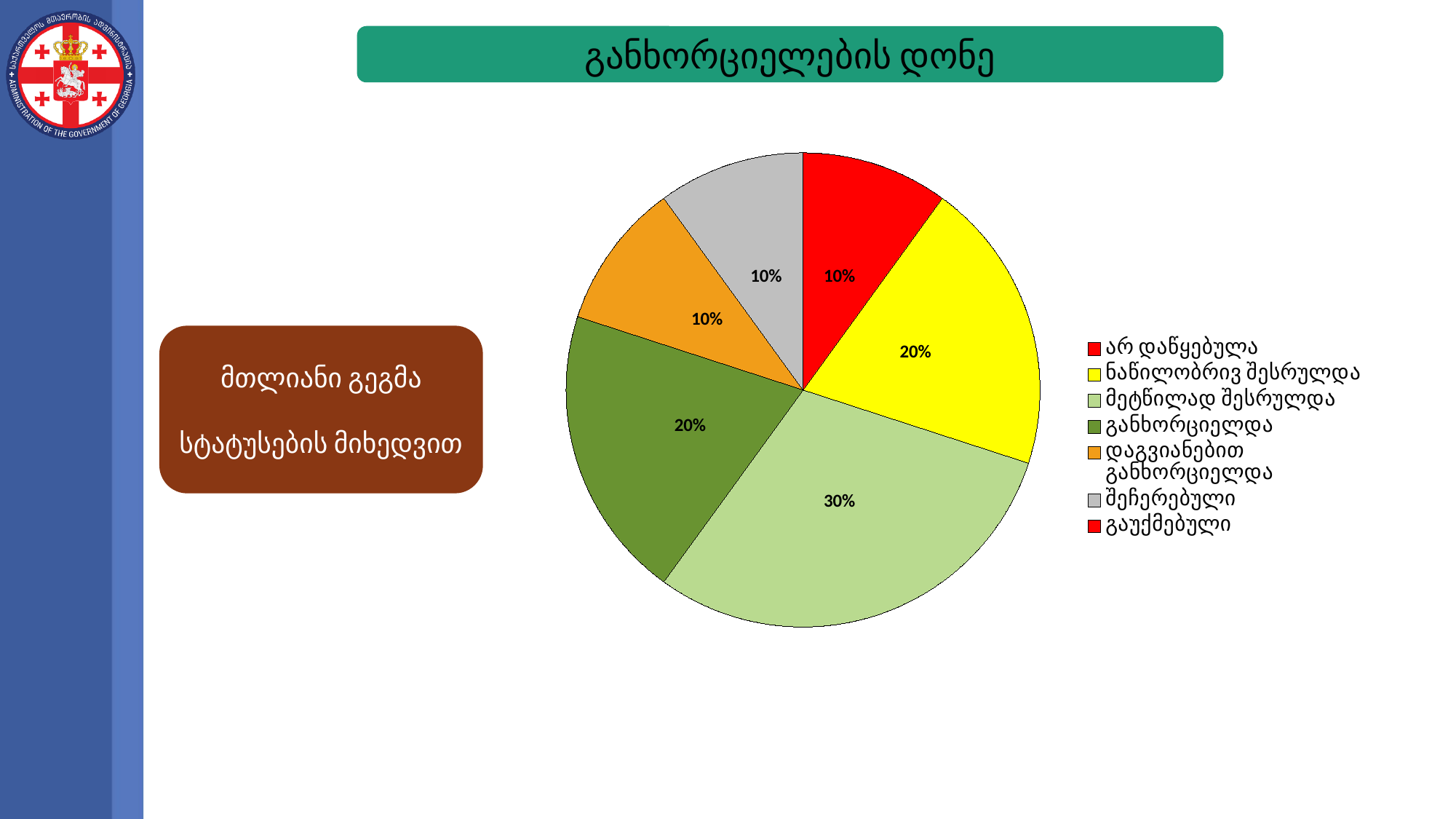
How many entries does the legend list? 7 What is the difference between the share for მეტწილად შესრულდა and the share for განხორციელდა? 10% What kind of chart is shown on the slide? pie chart What percentage of the pie does განხორციელდა represent? 20% Which category has the largest slice of the pie? მეტწილად შესრულდა Which is larger: the share for ნაწილობრივ შესრულდა or the share for შეჩერებული? ნაწილობრივ შესრულდა What percentage of the pie does მეტწილად შესრულდა represent? 30% What percentage of the pie does ნაწილობრივ შესრულდა represent? 20% What percentage of the pie does დაგვიანებით განხორციელდა represent? 10% What percentage of the pie does შეჩერებული represent? 10% What is the title shown above the chart? განხორციელების დონე How many slices does the pie chart have? 6